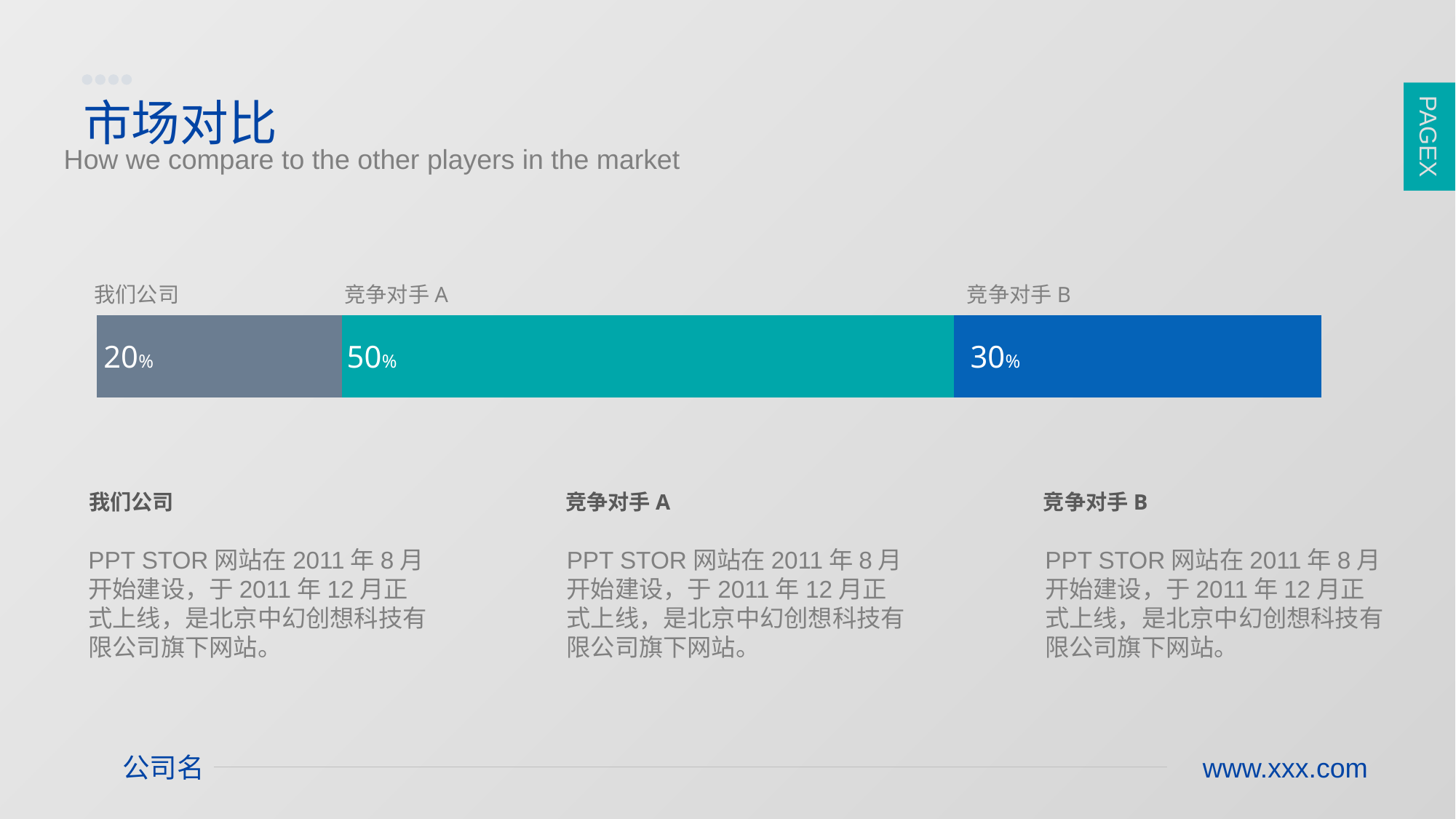
What is the value for 我们公司? 20% What is the value for 竞争对手 B? 30% Which segment has the highest value? 竞争对手 A Which segment has the lowest value? 我们公司 What kind of chart is shown on the slide? Stacked bar chart Which is larger, the value for 竞争对手 B or the value for 我们公司? 竞争对手 B What is the difference between the values for 竞争对手 B and 我们公司? 10% How many segments make up the stacked bar? 3 What is the value for 竞争对手 A? 50% What is the total of the three segments in the stacked bar? 100% What is the difference between the values for 竞争对手 A and 我们公司? 30% What colour is the segment for 竞争对手 A? Teal